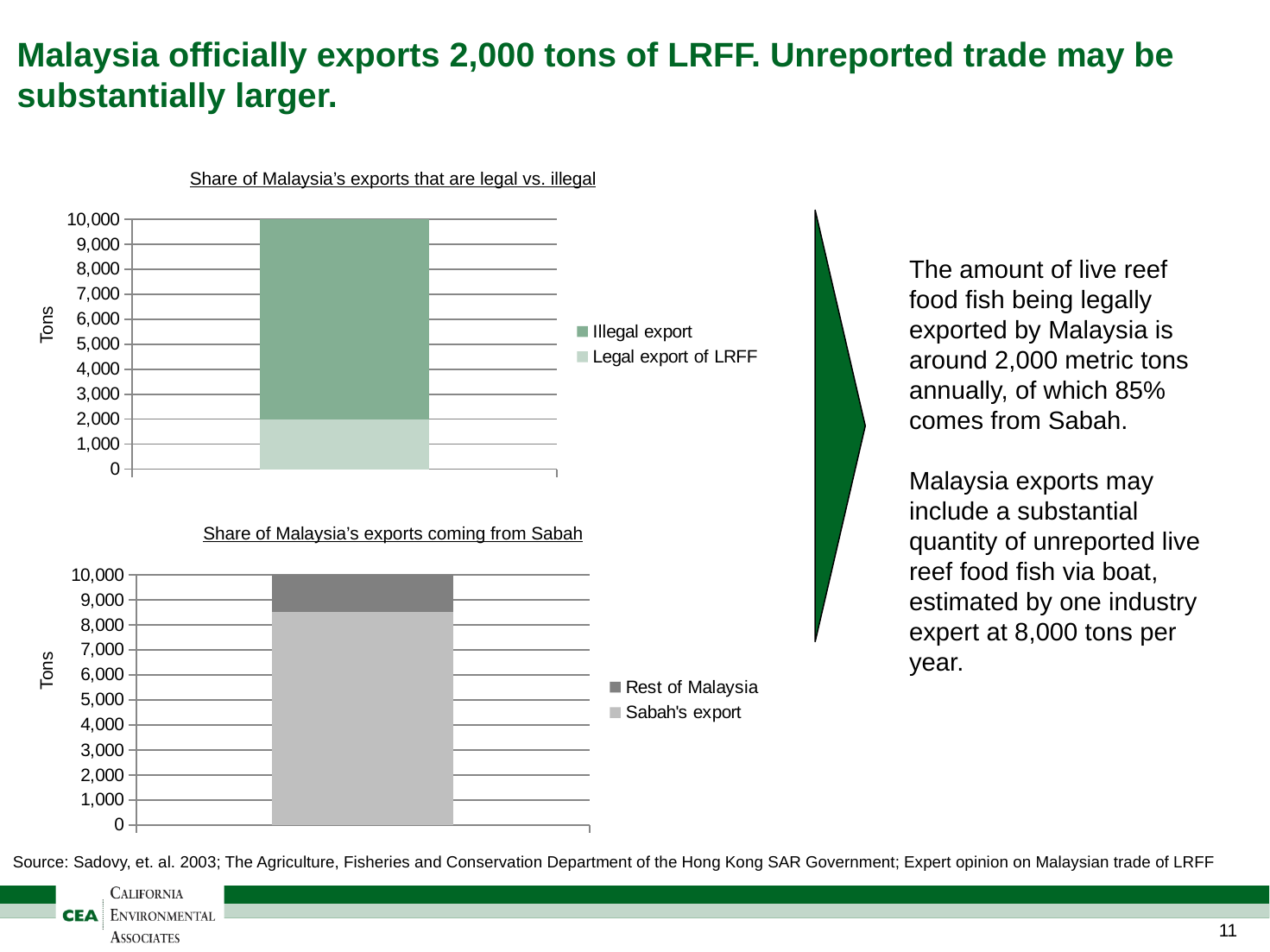
In the 'Share of Malaysia's exports that are legal vs. illegal' chart, is the value for Illegal export greater or less than 5,000? greater In the 'Share of Malaysia's exports coming from Sabah' chart, what is the total height of the stacked bar? 10,000 In the 'Share of Malaysia's exports that are legal vs. illegal' chart, which series is larger, Illegal export or Legal export of LRFF? Illegal export What kind of chart is the 'Share of Malaysia's exports that are legal vs. illegal' chart? Stacked bar chart In the 'Share of Malaysia's exports coming from Sabah' chart, is the value for Rest of Malaysia greater or less than 2,000? less In the 'Share of Malaysia's exports that are legal vs. illegal' chart, what is the value for Legal export of LRFF? 2,000 In the 'Share of Malaysia's exports that are legal vs. illegal' chart, what is the total height of the stacked bar? 10,000 In the 'Share of Malaysia's exports coming from Sabah' chart, which series is larger, Rest of Malaysia or Sabah's export? Sabah's export How many series does the legend of the 'Share of Malaysia's exports that are legal vs. illegal' chart list? 2 What is the y-axis label on the 'Share of Malaysia's exports that are legal vs. illegal' chart? Tons How many series does the legend of the 'Share of Malaysia's exports coming from Sabah' chart list? 2 In the 'Share of Malaysia's exports coming from Sabah' chart, is the value for Sabah's export greater or less than 8,000? greater